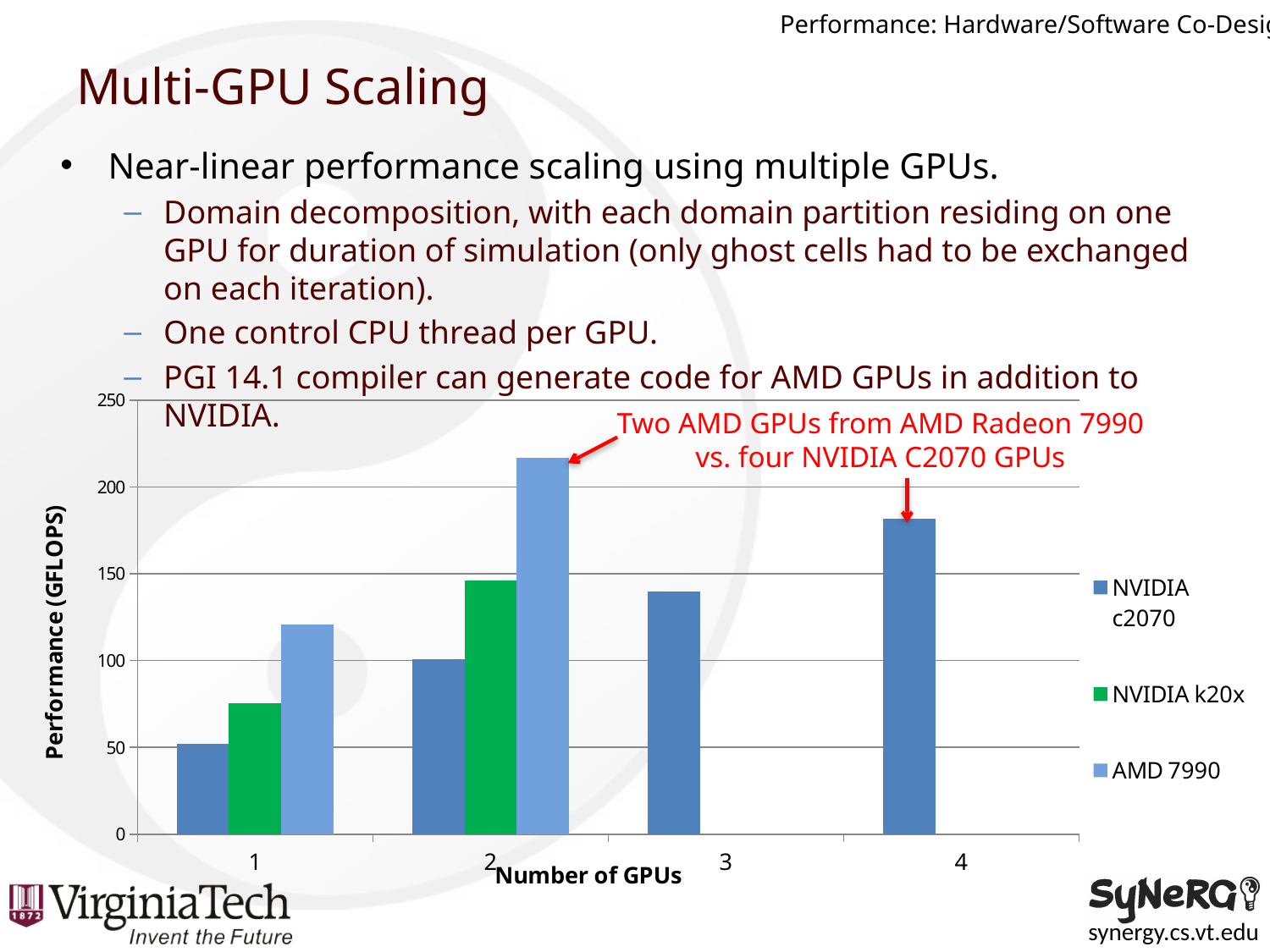
Which series has the highest bar in the chart? AMD 7990 Is the value for AMD 7990 at 2 GPUs greater or less than 200? greater What is the label of the vertical axis? Performance (GFLOPS) Is the value for AMD 7990 at 1 GPU greater or less than 100? greater Is the value for NVIDIA c2070 at 3 GPUs greater or less than 150? less Does the NVIDIA c2070 performance rise or fall as the number of GPUs increases? rise How many categories (numbers of GPUs) are shown on the x axis? 4 What kind of chart is shown on the slide? bar chart At 1 GPU, which is larger: NVIDIA k20x or AMD 7990? AMD 7990 How many series does the chart legend list? 3